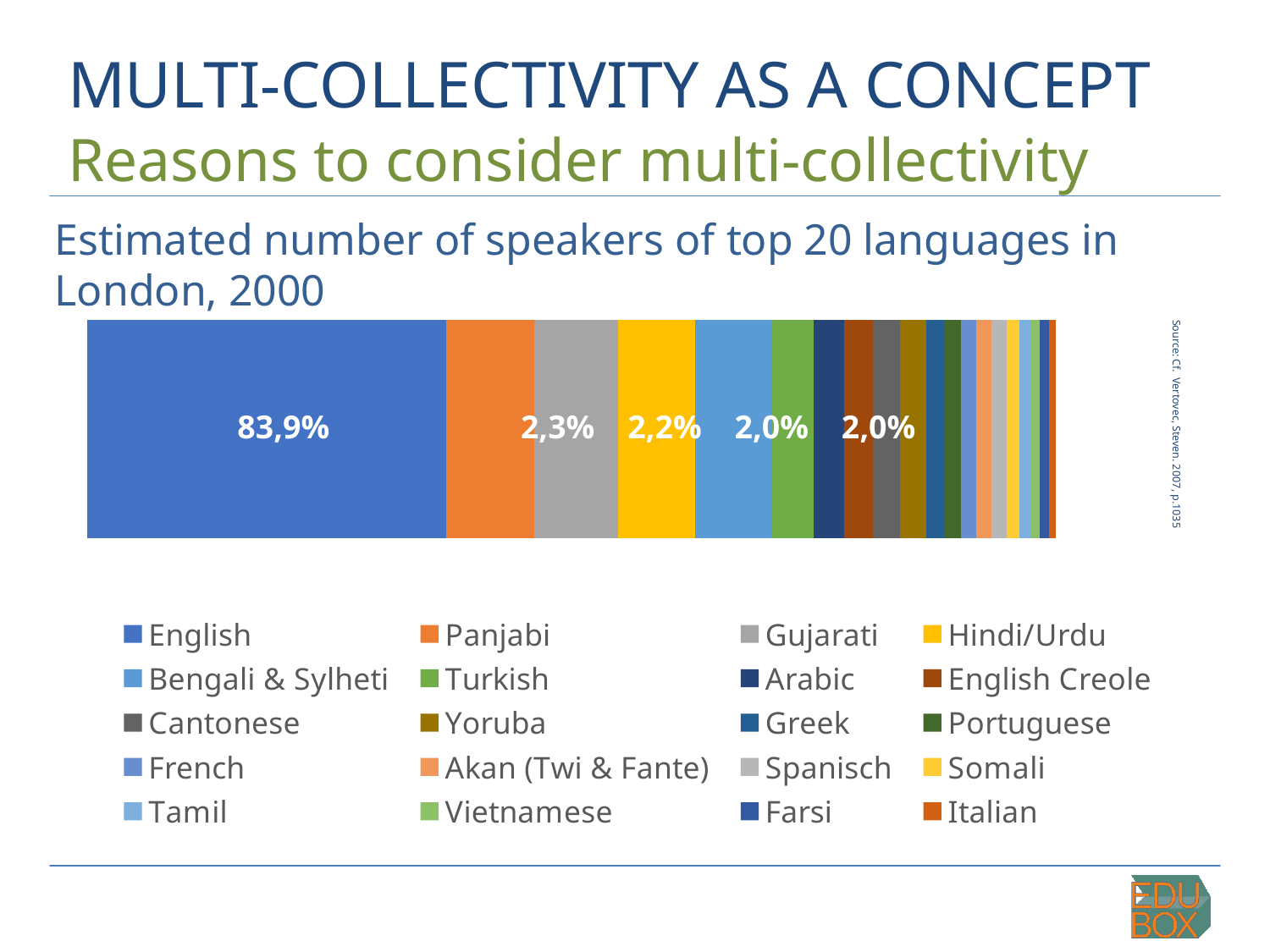
How many languages does the legend list? 20 What percentage is shown for English? 83,9% Which language is listed first in the legend? English What colour represents English in the chart? blue What is the title of the chart? Estimated number of speakers of top 20 languages in London, 2000 What is the largest percentage label printed on the bar? 83,9% How many percentage labels are printed on the bar? 5 What kind of chart is shown on the slide? bar chart Which is larger, the share for English or the share for Panjabi? English Which language has the largest share of the bar? English